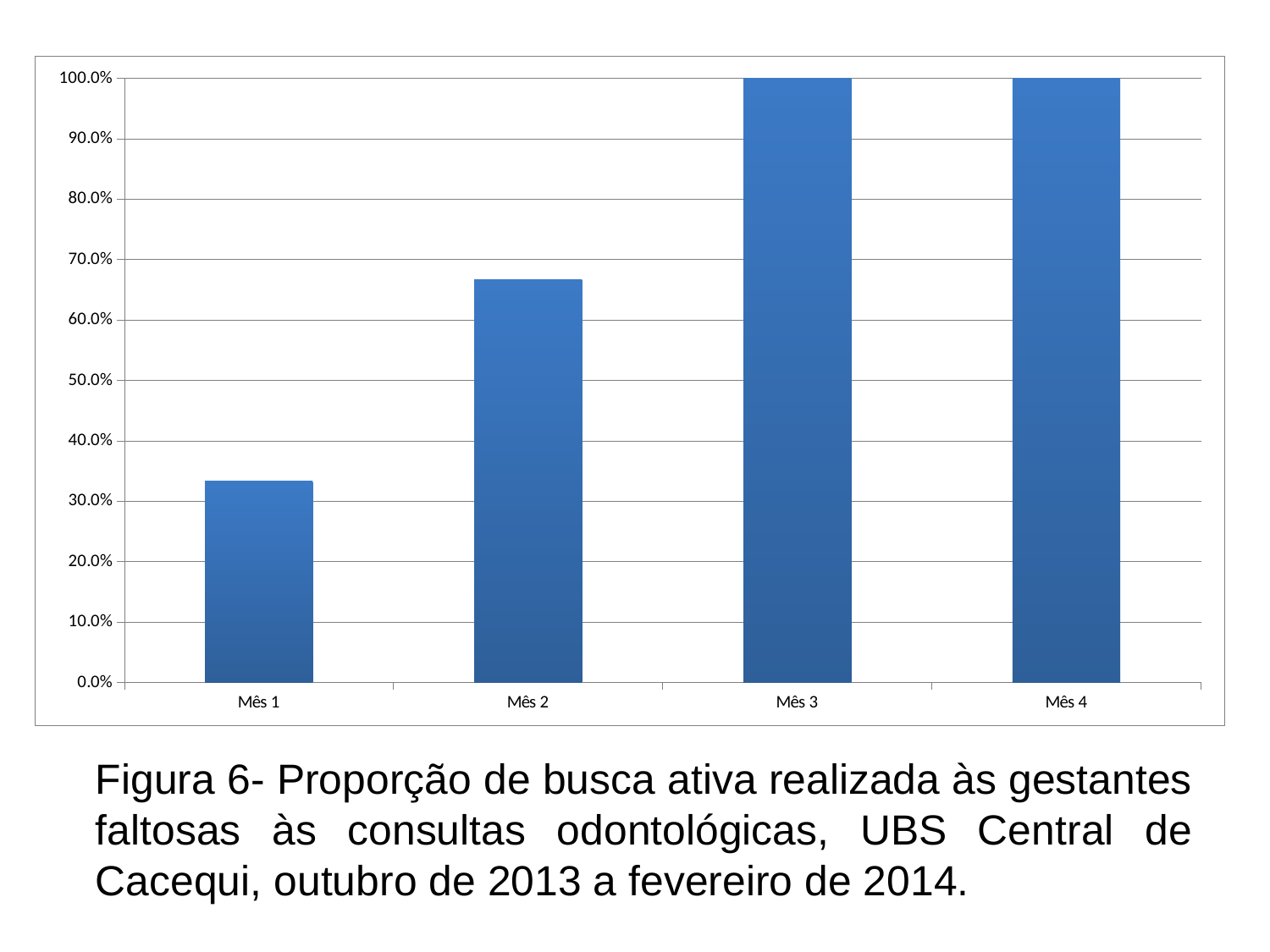
What is the value for Mês 4? 100.0% How many categories (months) are shown on the x axis of the chart? 4 Is the value for Mês 1 greater or less than 40.0%? less What kind of chart is shown on the slide? bar chart Is the value for Mês 1 greater or less than 30.0%? greater What figure number is given in the caption below the chart? Figura 6 Is the value for Mês 2 greater or less than 70.0%? less What is the value for Mês 3? 100.0% Which is larger, the value for Mês 1 or the value for Mês 2? Mês 2 Which month has the lowest value in the chart? Mês 1 Do the values rise or fall from Mês 1 to Mês 4? rise